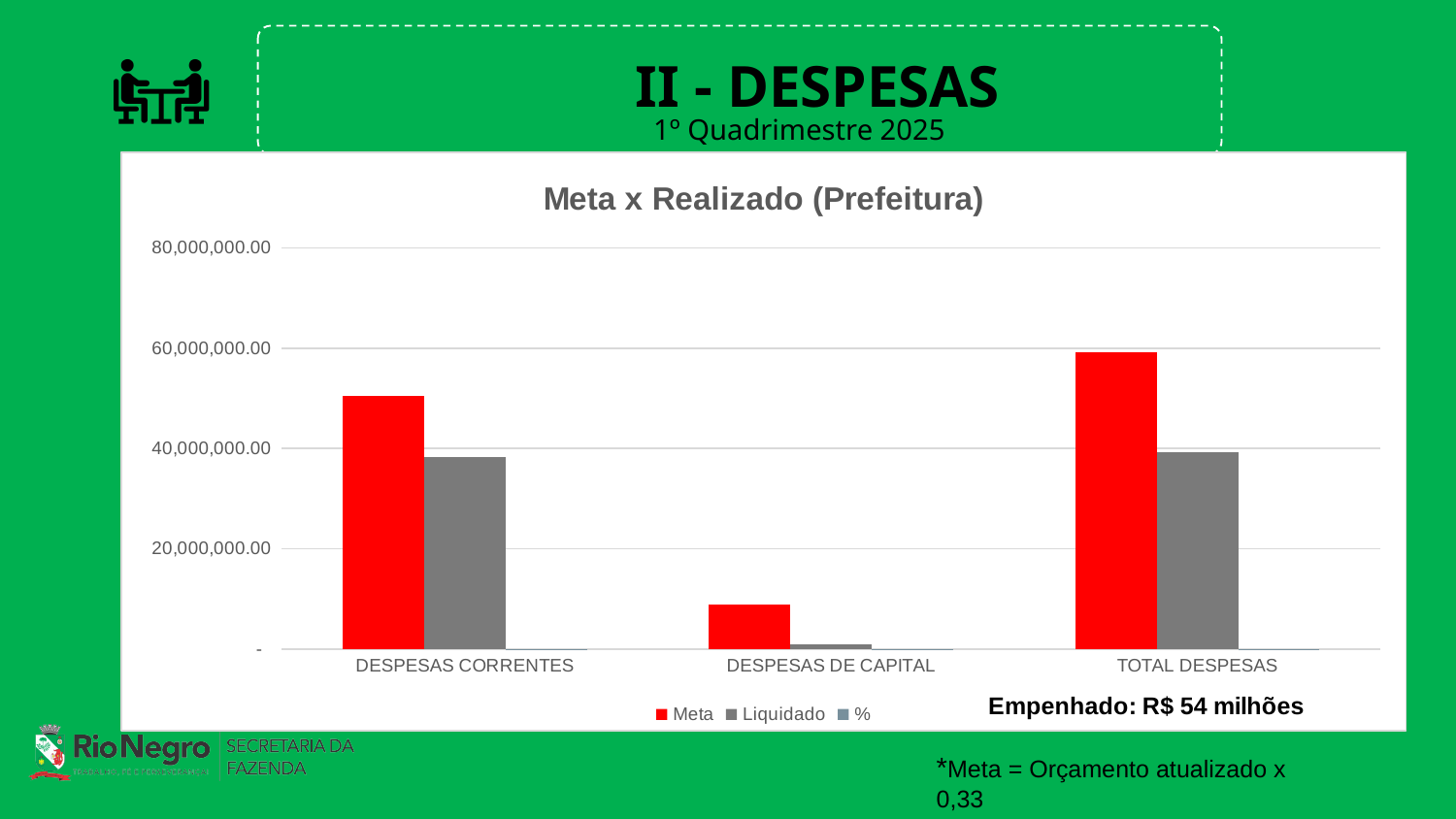
Which category has the lowest Liquidado value? DESPESAS DE CAPITAL What is the title of the chart? Meta x Realizado (Prefeitura) How many series does the chart legend list? 3 Is the Meta value for DESPESAS DE CAPITAL greater or less than 20,000,000.00? less Which series are listed in the chart legend? Meta, Liquidado, % How many categories are shown on the x axis of the chart? 3 Which category has the lowest Meta value? DESPESAS DE CAPITAL What type of chart is shown on the slide? bar chart Which category has the highest Meta value? TOTAL DESPESAS Is the Meta value for DESPESAS CORRENTES greater or less than 40,000,000.00? greater Is the Liquidado value for TOTAL DESPESAS greater or less than 60,000,000.00? less For DESPESAS CORRENTES, which is larger: Meta or Liquidado? Meta